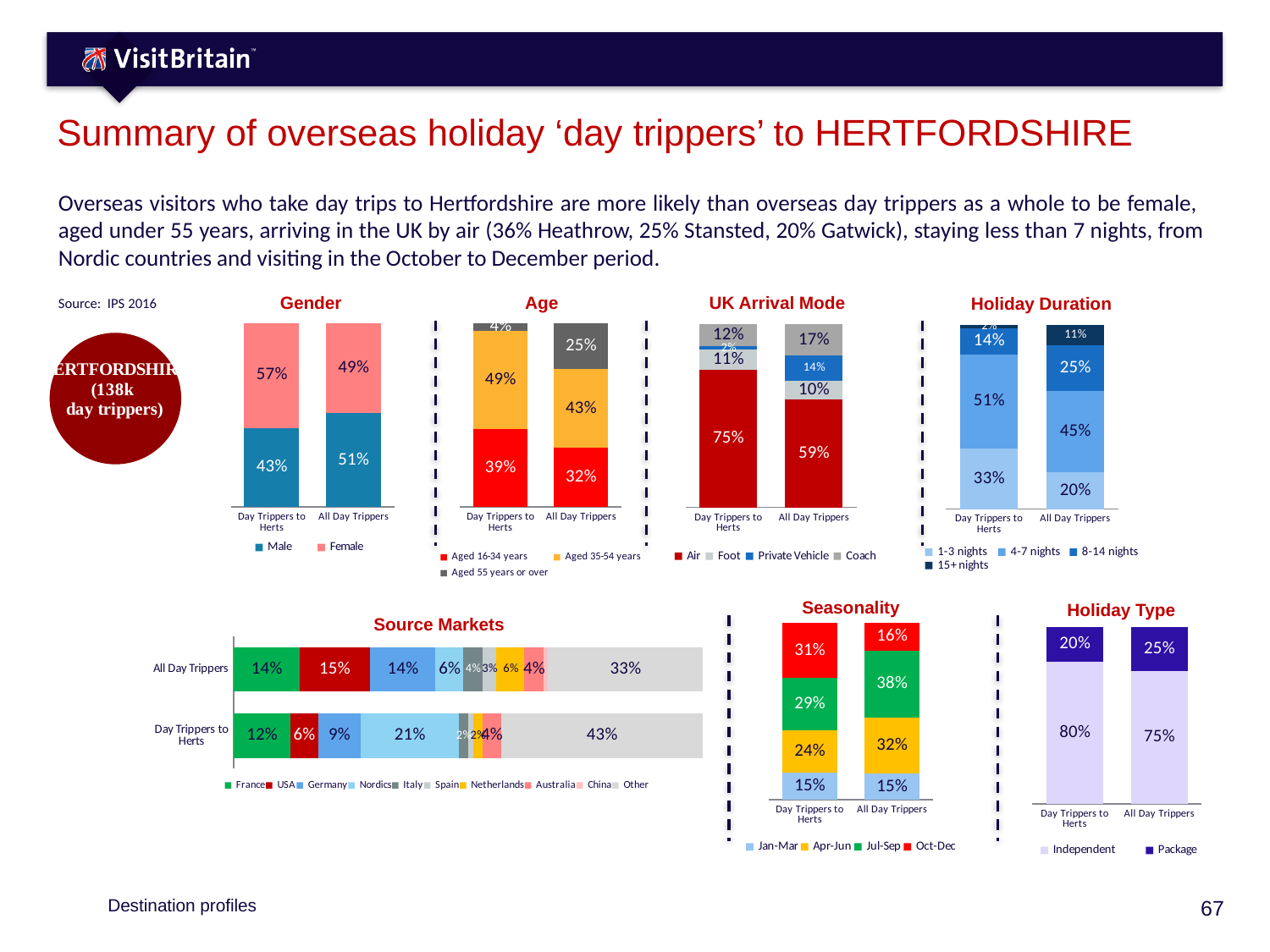
In the Seasonality chart, which quarter has the highest share for All Day Trippers? Jul-Sep In the Age chart, what is the difference between the share of Day Trippers to Herts aged 35-54 years and the share of All Day Trippers aged 35-54 years? 6% How many series does the legend of the Holiday Type chart list? 2 In the Gender chart, what percentage of Day Trippers to Herts are female? 57% In the Holiday Duration chart, which group has the larger share staying 1-3 nights, Day Trippers to Herts or All Day Trippers? Day Trippers to Herts In the UK Arrival Mode chart, what percentage of Day Trippers to Herts arrive by air? 75% In the Gender chart, what percentage of All Day Trippers are male? 51% In the Age chart, what percentage of All Day Trippers are aged 55 years or over? 25% In the Holiday Duration chart, what percentage of Day Trippers to Herts stay 4-7 nights? 51% In the UK Arrival Mode chart, which arrival mode is the largest for All Day Trippers? Air In the Source Markets chart, what percentage of Day Trippers to Herts come from the Nordics? 21% In the Seasonality chart, what percentage of Day Trippers to Herts visit in the Oct-Dec period? 31%